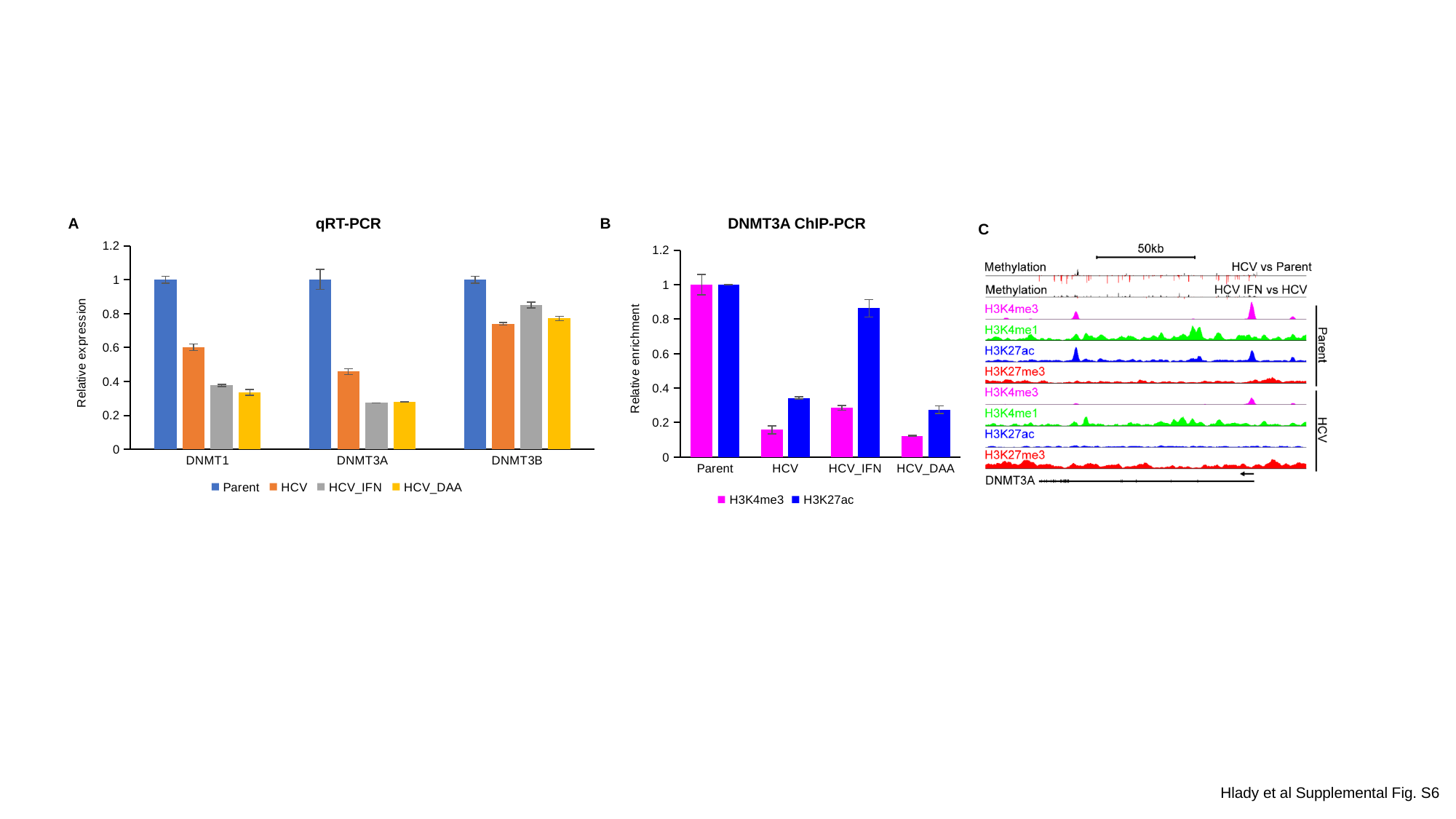
In the qRT-PCR chart, which series has the highest value for DNMT3A? Parent In the DNMT3A ChIP-PCR chart, is the H3K27ac value for HCV_IFN greater or less than 0.8? greater In the qRT-PCR chart, how many series does the legend list? 4 In the qRT-PCR chart, is the value for HCV_IFN in DNMT3B greater or less than 0.8? greater In the qRT-PCR chart, for DNMT3B, which is larger: HCV or HCV_IFN? HCV_IFN In the DNMT3A ChIP-PCR chart, what is the relative enrichment of H3K27ac for Parent? 1 What kind of chart is the qRT-PCR chart (panel A)? bar chart In the qRT-PCR chart, what is the relative expression of Parent for DNMT1? 1 In the DNMT3A ChIP-PCR chart, for HCV_IFN, which is larger: H3K4me3 or H3K27ac? H3K27ac In the DNMT3A ChIP-PCR chart, how many series does the legend list? 2 In the qRT-PCR chart, how many gene categories are shown on the x axis? 3 In the qRT-PCR chart, is the value for HCV_DAA in DNMT1 greater or less than 0.4? less